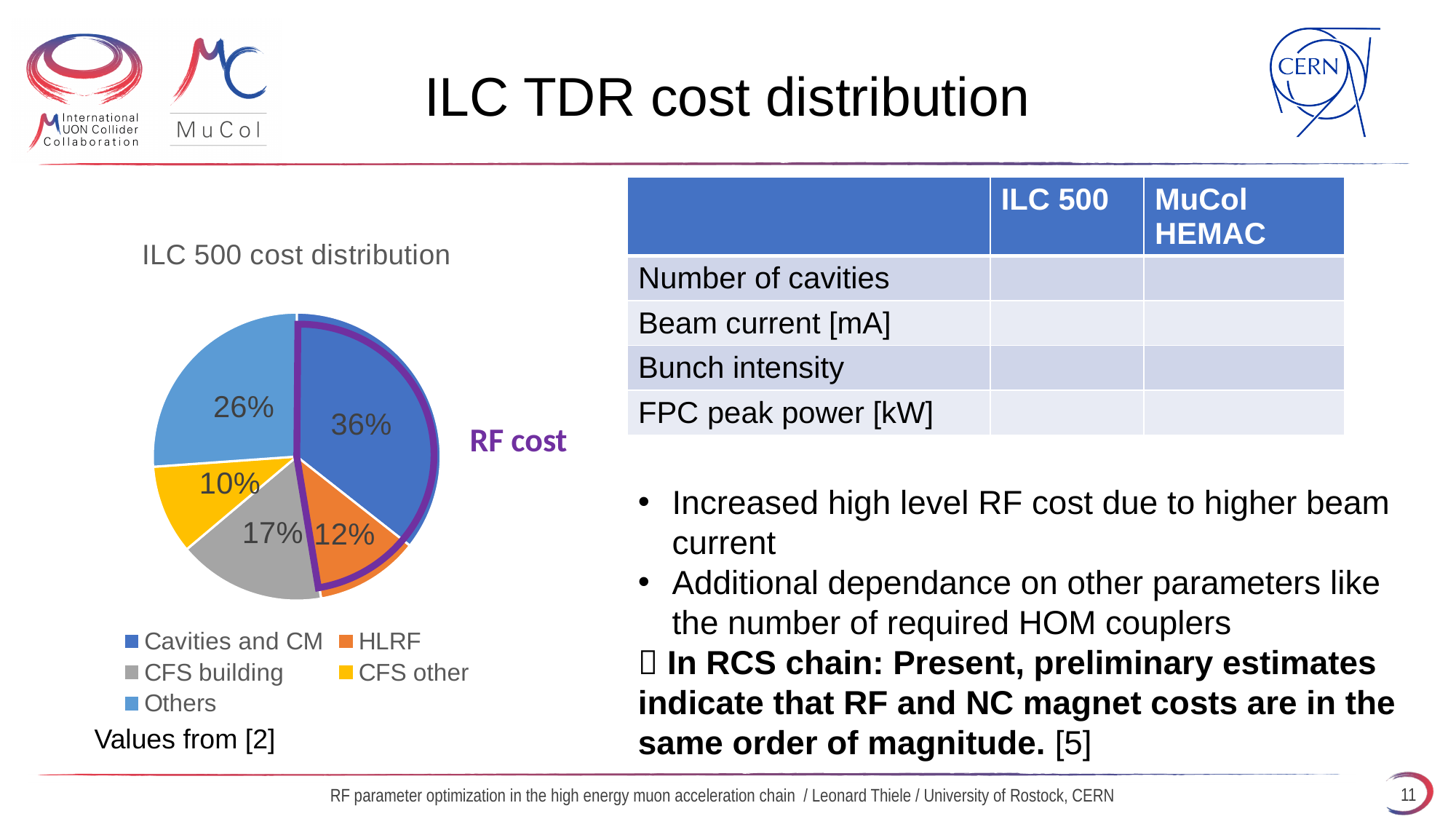
What share of the ILC 500 cost distribution is HLRF? 12% How many categories does the pie chart show? 5 What share of the ILC 500 cost distribution is CFS other? 10% What is the title of the chart? ILC 500 cost distribution What share of the ILC 500 cost distribution is CFS building? 17% Which category has the largest share of the ILC 500 cost distribution? Cavities and CM What share of the ILC 500 cost distribution is Cavities and CM? 36% What share of the ILC 500 cost distribution is Others? 26% What is the difference in percentage points between the Cavities and CM share and the Others share? 10 What type of chart is shown on the slide? Pie chart Which category has the smallest share of the ILC 500 cost distribution? CFS other Which is larger, the CFS building share or the HLRF share? CFS building